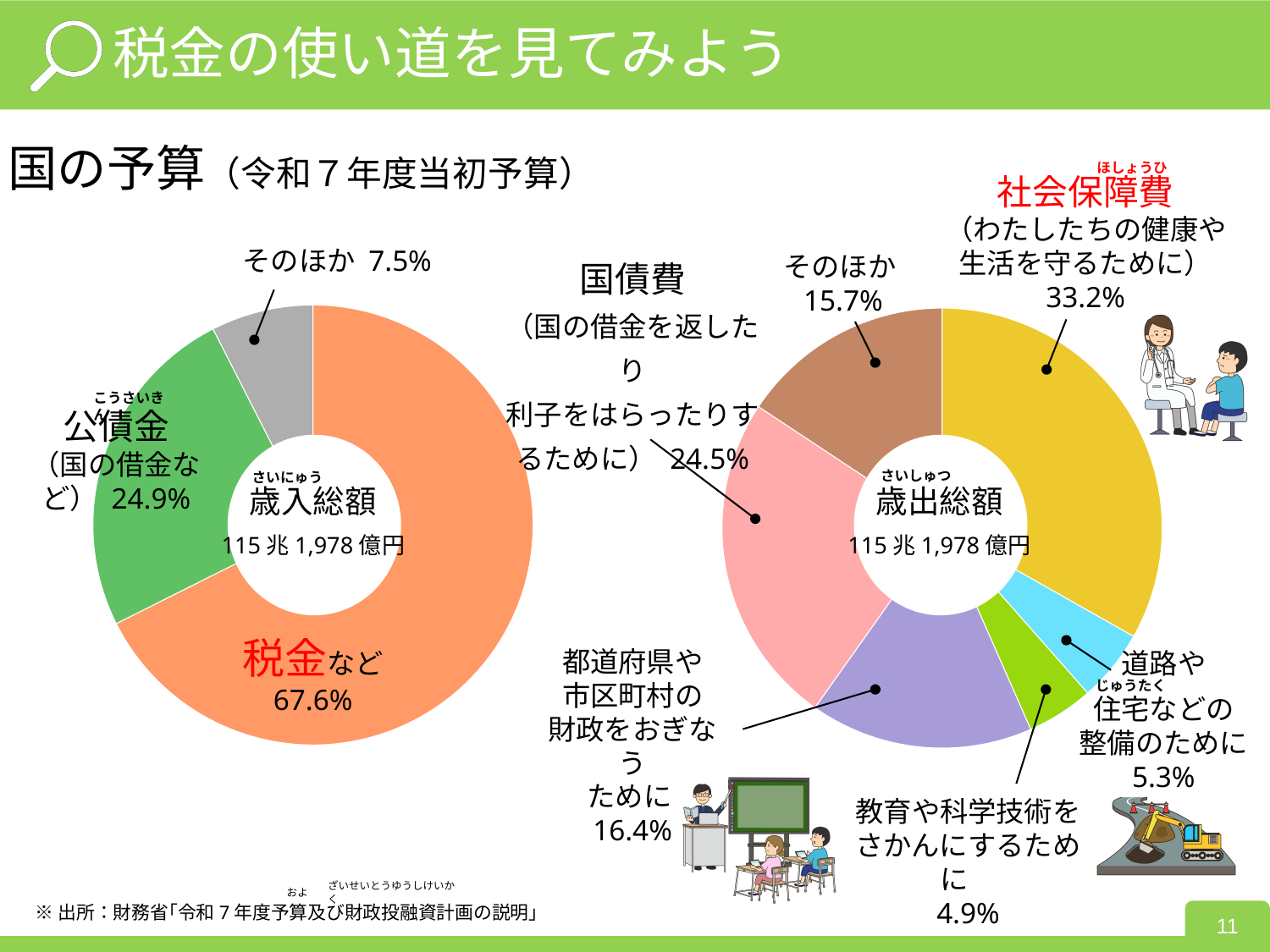
In the 歳入総額 chart on the left, what percentage is 公債金? 24.9% How many categories does the 歳出総額 chart on the right show? 6 In the 歳出総額 chart on the right, what percentage is 国債費? 24.5% In the 歳出総額 chart on the right, what percentage is 社会保障費? 33.2% In the 歳入総額 chart on the left, what is the difference between 税金など and 公債金? 42.7% What total amount is shown in the centre of the 歳出総額 chart on the right? 115兆1,978億円 What kind of chart is the 歳入総額 chart on the left? Donut (pie) chart In the 歳入総額 chart on the left, what percentage is 税金など? 67.6% How many categories does the 歳入総額 chart on the left show? 3 In the 歳出総額 chart on the right, which category has the smallest share? 教育や科学技術をさかんにするために In the 歳出総額 chart on the right, which category has the largest share? 社会保障費 In the 歳出総額 chart on the right, which is larger: 道路や住宅などの整備のために or 教育や科学技術をさかんにするために? 道路や住宅などの整備のために